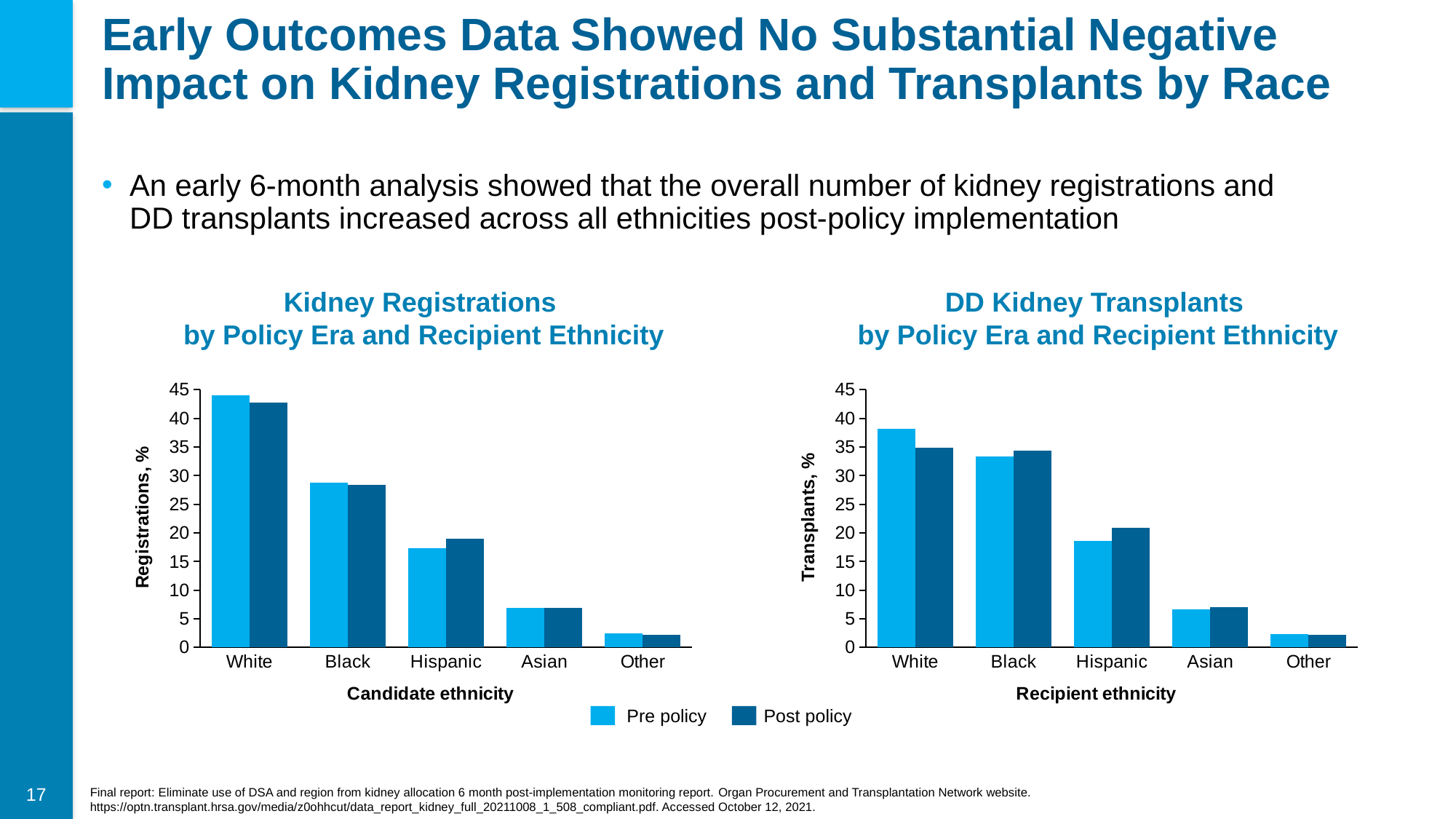
In the Kidney Registrations chart, what kind of chart is used? bar chart In the Kidney Registrations chart, is the Pre policy value for White greater or less than 40? greater In the Kidney Registrations chart, how many ethnicity categories are shown on the x axis? 5 In the DD Kidney Transplants chart, which recipient ethnicity has the lowest Post policy value? Other In the Kidney Registrations chart, which is larger for Hispanic: the Pre policy value or the Post policy value? Post policy In the Kidney Registrations chart, do the Pre policy values rise or fall moving from White to Other along the x axis? fall In the Kidney Registrations chart, which candidate ethnicity has the highest Pre policy value? White How many series does the shared legend list for the two charts? 2 In the DD Kidney Transplants chart, is the Post policy value for Black greater or less than 30? greater What is the y-axis label of the DD Kidney Transplants chart? Transplants, % In the DD Kidney Transplants chart, is the Pre policy value for Hispanic greater or less than 20? less In the DD Kidney Transplants chart, which is larger for White: the Pre policy value or the Post policy value? Pre policy